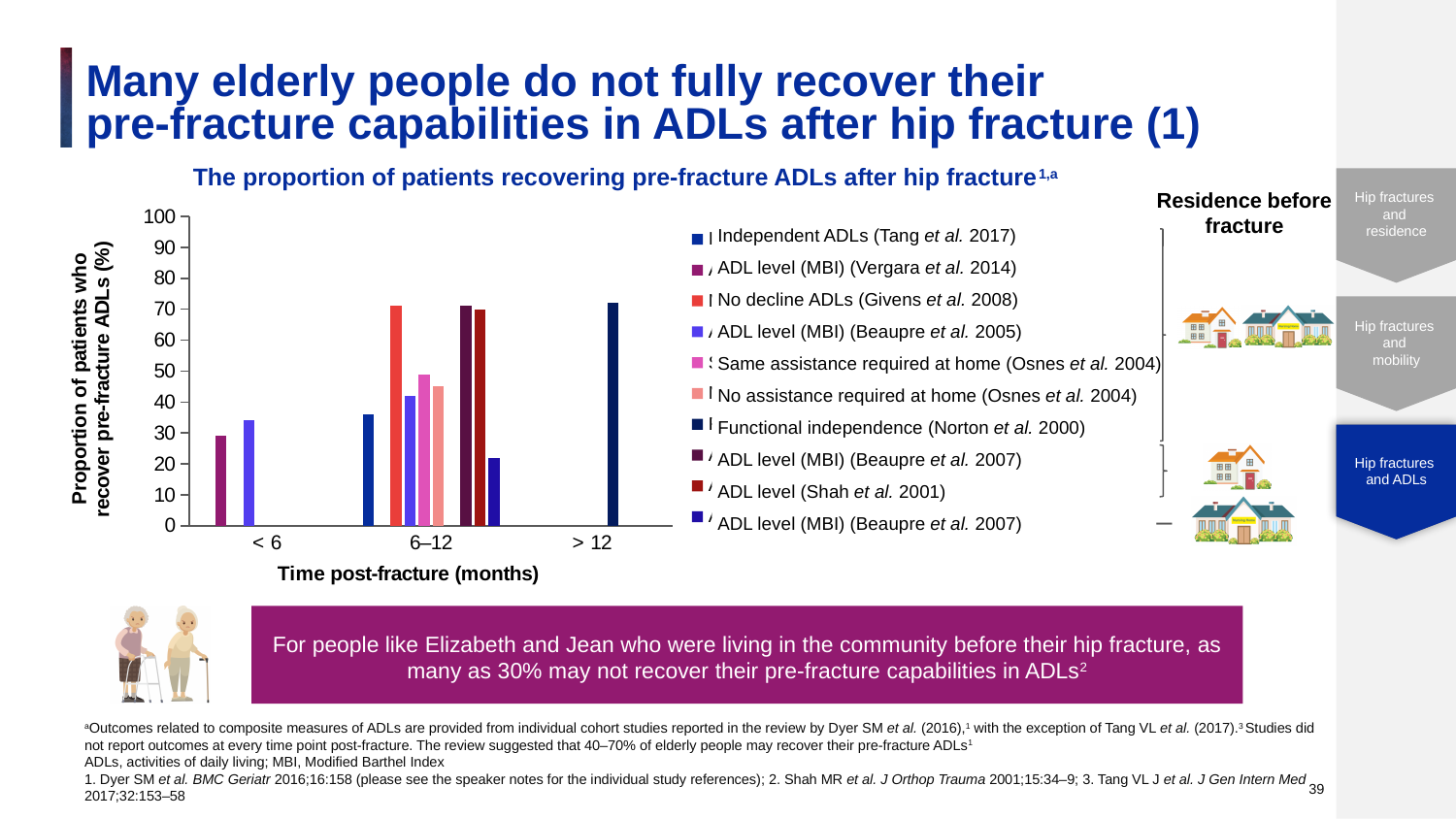
What is the label of the y axis? Proportion of patients who recover pre-fracture ADLs (%) Is the value of the tallest bar in the < 6 months category greater or less than 40? less Is the value of the tallest bar in the 6–12 months category greater or less than 60? greater How many bars are plotted in the 6–12 months category? 8 Is the value of the shortest bar in the 6–12 months category greater or less than 30? less How many series does the legend list? 10 How many bars are plotted in the < 6 months category? 2 What kind of chart is shown on the slide? Bar chart How many time post-fracture categories are shown on the x axis? 3 Which time post-fracture category has the fewest bars plotted? > 12 What is the title of the chart? The proportion of patients recovering pre-fracture ADLs after hip fracture